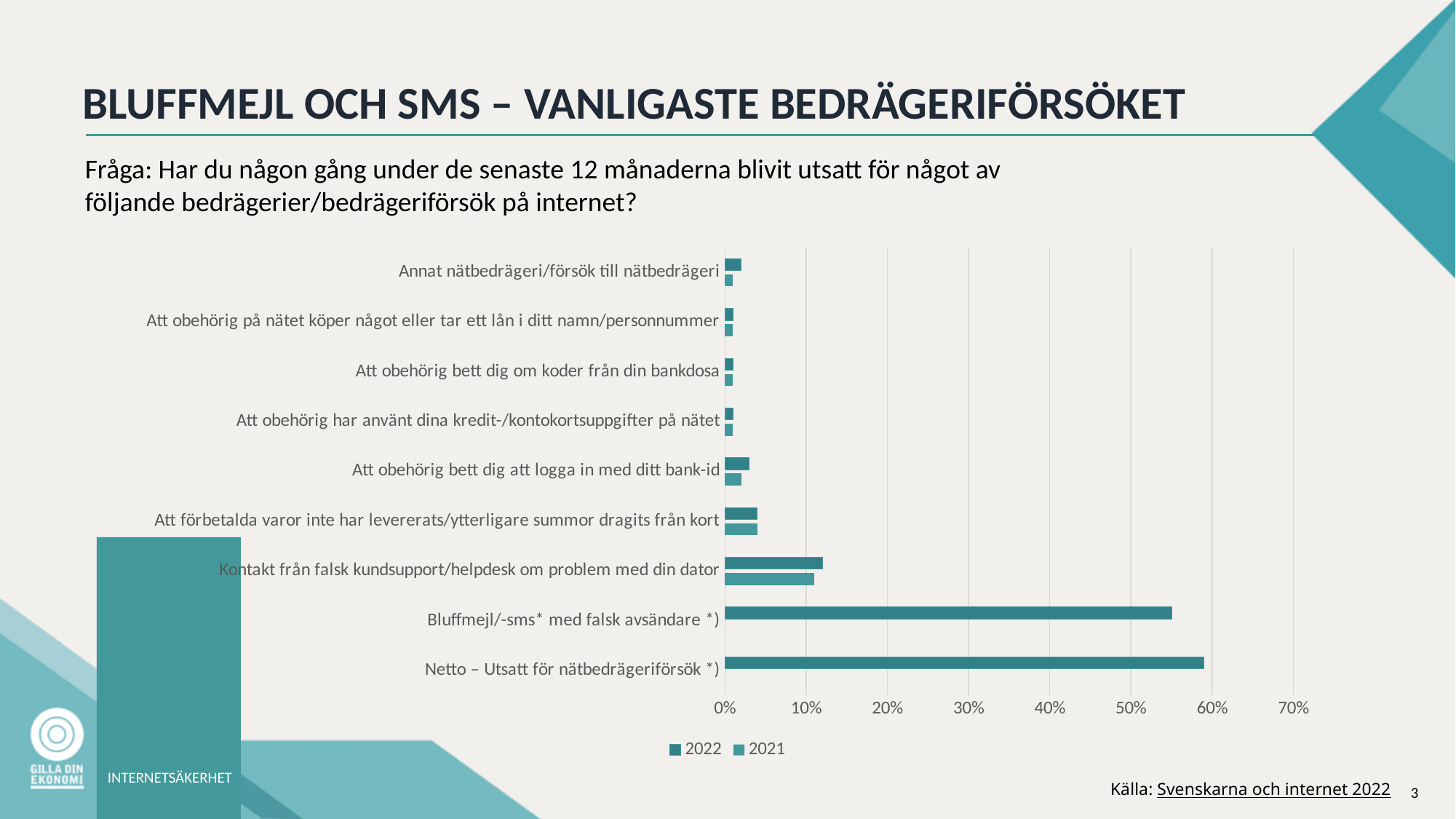
Which has the larger 2022 value: Bluffmejl/-sms* med falsk avsändare or Kontakt från falsk kundsupport/helpdesk om problem med din dator? Bluffmejl/-sms* med falsk avsändare Is the 2022 value for Att förbetalda varor inte har levererats/ytterligare summor dragits från kort greater or less than 10%? less Which years are listed in the chart legend? 2022 and 2021 Which has the larger 2022 value: Kontakt från falsk kundsupport/helpdesk om problem med din dator or Att obehörig bett dig att logga in med ditt bank-id? Kontakt från falsk kundsupport/helpdesk om problem med din dator What kind of chart is shown on the slide? bar chart Is the 2022 value for Netto – Utsatt för nätbedrägeriförsök greater or less than 50%? greater Is the 2022 value for Bluffmejl/-sms* med falsk avsändare greater or less than 50%? greater Which category has the highest value in the chart? Netto – Utsatt för nätbedrägeriförsök *) How many series does the legend list? 2 What is the highest value shown on the x axis of the chart? 70% How many categories are shown on the chart? 9